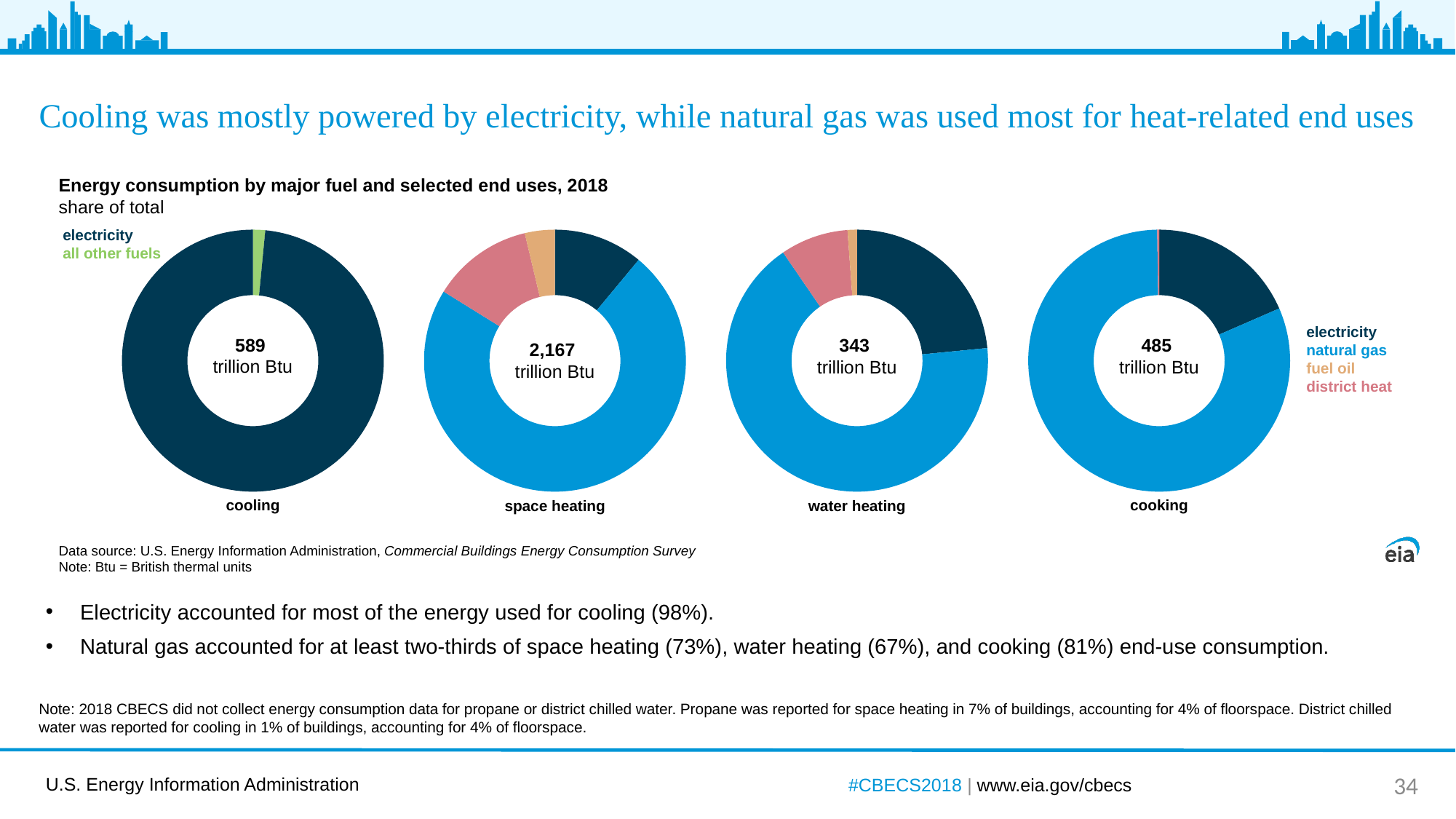
What total is shown in the center of the water heating donut chart? 343 trillion Btu What total is shown in the center of the space heating donut chart? 2,167 trillion Btu How many donut charts are shown on the slide? 4 Which has a larger total energy consumption, cooking or water heating? cooking In the cooking donut chart, what share of energy consumption is natural gas? 81% What is the difference in total energy consumption between space heating and cooling? 1,578 trillion Btu What total is shown in the center of the cooking donut chart? 485 trillion Btu How many fuel categories does the legend list for the space heating, water heating, and cooking charts? 4 What kind of chart is used to show energy consumption by major fuel for each end use? donut (pie) chart Which end use has the largest total energy consumption among the four donut charts? space heating What total is shown in the center of the cooling donut chart? 589 trillion Btu Which end use has the smallest total energy consumption among the four donut charts? water heating